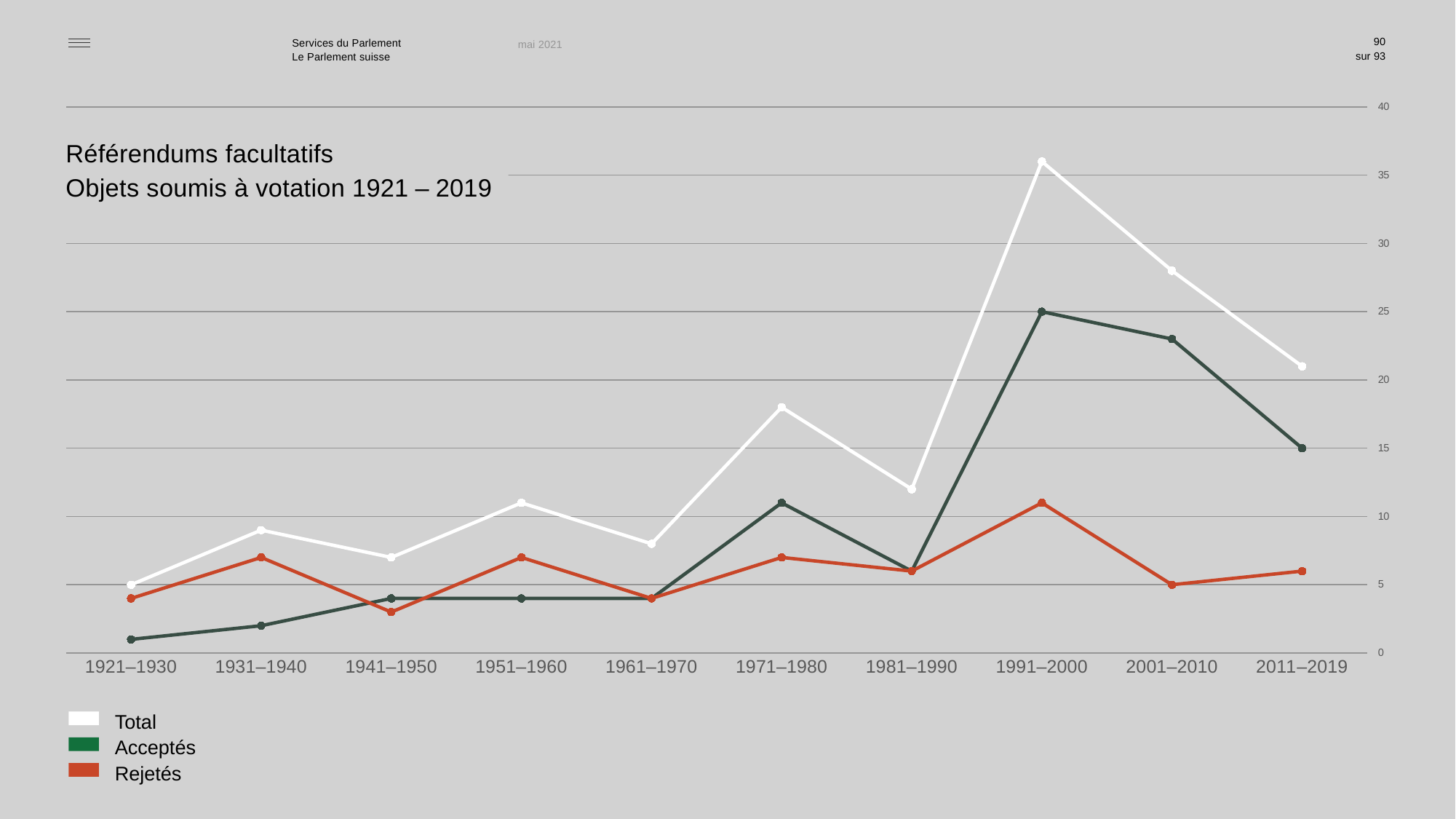
What is the value of Acceptés for 2011–2019? 15 What kind of chart is shown on the slide? line chart How many series does the legend list? 3 In which period is the Total series highest? 1991–2000 What is the value of Total for 1921–1930? 5 Is the value of Total for 1991–2000 greater or less than 30? greater In which period is the Acceptés series lowest? 1921–1930 Does the Total series rise or fall from 1991–2000 to 2011–2019? fall In 1991–2000, which is larger: Acceptés or Rejetés? Acceptés Is the value of Acceptés for 1921–1930 greater or less than 5? less What is the value of Acceptés for 1991–2000? 25 How many decade categories are shown on the x axis? 10